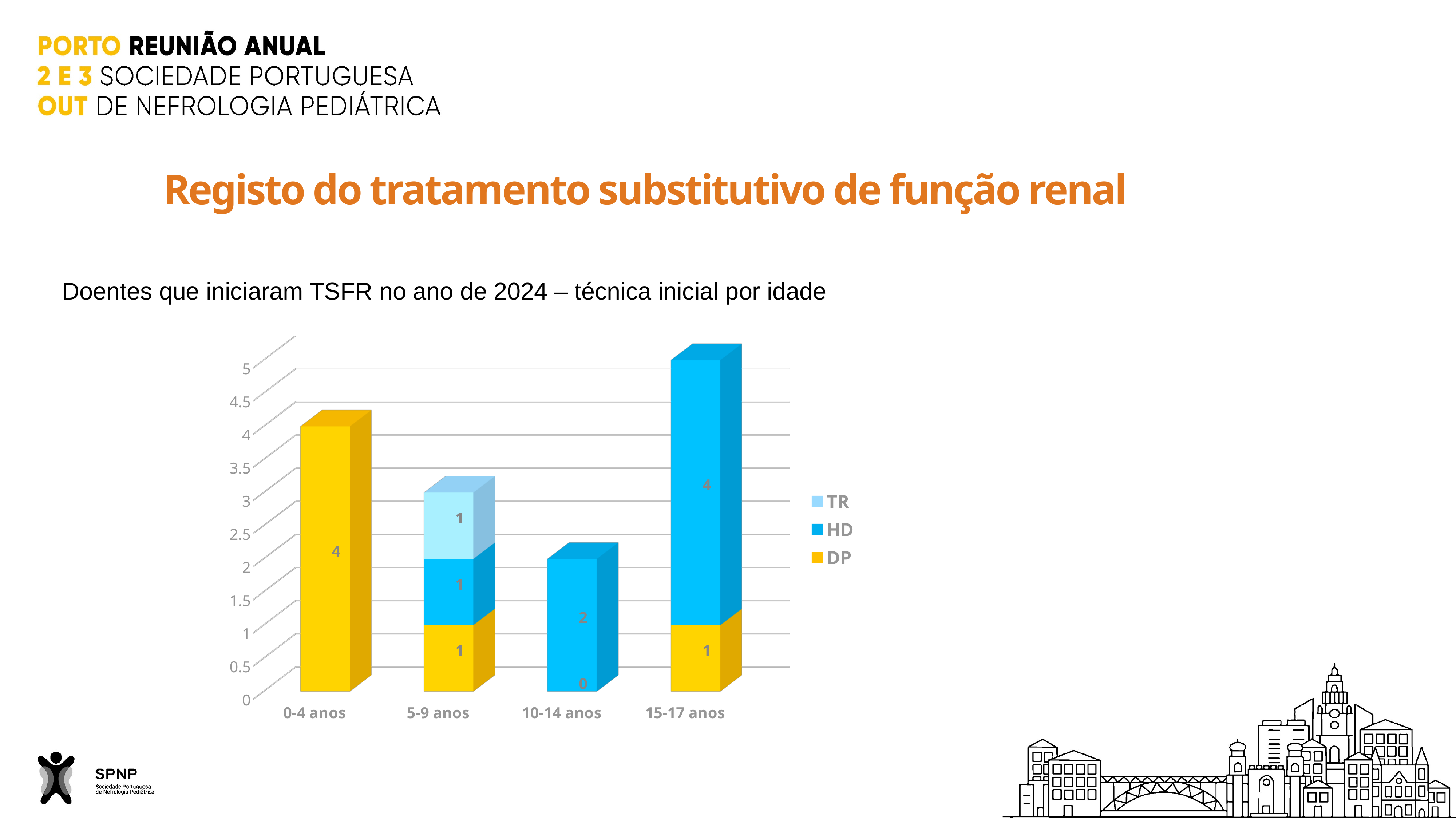
What is the DP value for the 0-4 anos category? 4 What is the HD value for the 15-17 anos category? 4 What is the total of the stacked bar for 5-9 anos? 3 How many series does the legend list? 3 What type of chart is shown on the slide? Stacked bar chart How many age categories are shown on the x axis? 4 What is the DP value for the 10-14 anos category? 0 What is the difference between the HD value for 15-17 anos and the HD value for 10-14 anos? 2 Which age category has the highest total stacked bar? 15-17 anos What is the HD value for the 10-14 anos category? 2 What is the TR value for the 5-9 anos category? 1 What is the total of the stacked bar for 15-17 anos? 5